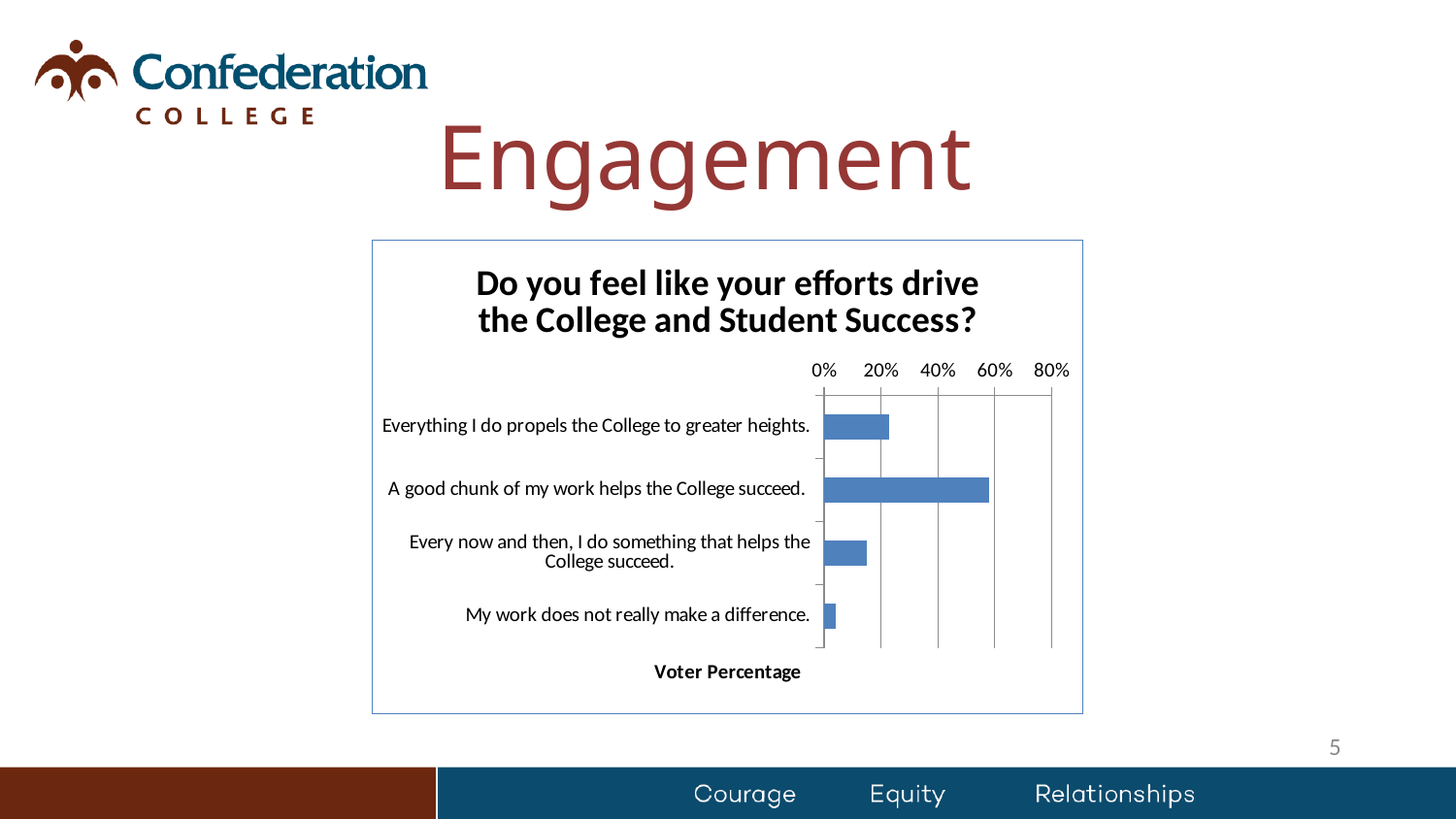
What is the title of the chart? Do you feel like your efforts drive the College and Student Success? Is the value for "A good chunk of my work helps the College succeed." greater or less than 40%? greater What kind of chart is shown on the slide? bar chart What is the label on the value axis of the chart? Voter Percentage Is the value for "My work does not really make a difference." greater or less than 20%? less How many response categories are plotted in the chart? 4 Is the value for "Everything I do propels the College to greater heights." greater or less than 40%? less Which response has the lowest voter percentage? My work does not really make a difference. Which has the larger voter percentage: "Everything I do propels the College to greater heights." or "Every now and then, I do something that helps the College succeed."? Everything I do propels the College to greater heights. Which has the larger voter percentage: "A good chunk of my work helps the College succeed." or "Everything I do propels the College to greater heights."? A good chunk of my work helps the College succeed. Which response has the highest voter percentage? A good chunk of my work helps the College succeed.